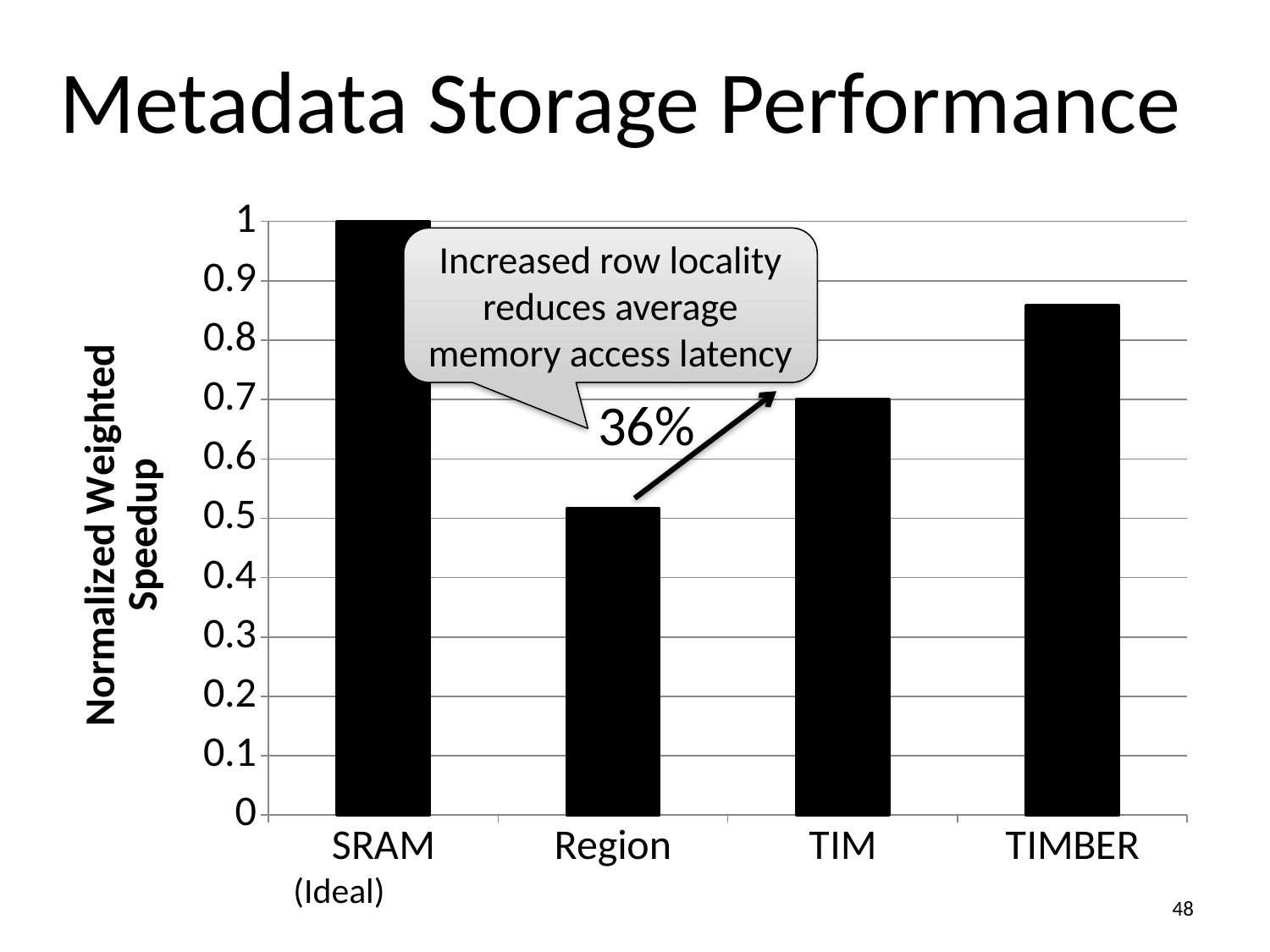
How many categories are plotted on the x axis? 4 Is the value for Region greater or less than 0.6? less What is the normalized weighted speedup for SRAM (Ideal)? 1 What percentage improvement is annotated between the Region and TIM bars? 36% What kind of chart is shown on the slide? bar chart Which category has the highest normalized weighted speedup? SRAM (Ideal) Which has a higher normalized weighted speedup, Region or TIM? TIM What is the label of the y axis? Normalized Weighted Speedup Which category has the lowest normalized weighted speedup? Region Which has a higher normalized weighted speedup, TIM or TIMBER? TIMBER Is the value for TIM greater or less than 0.6? greater Is the value for TIMBER greater or less than 0.8? greater